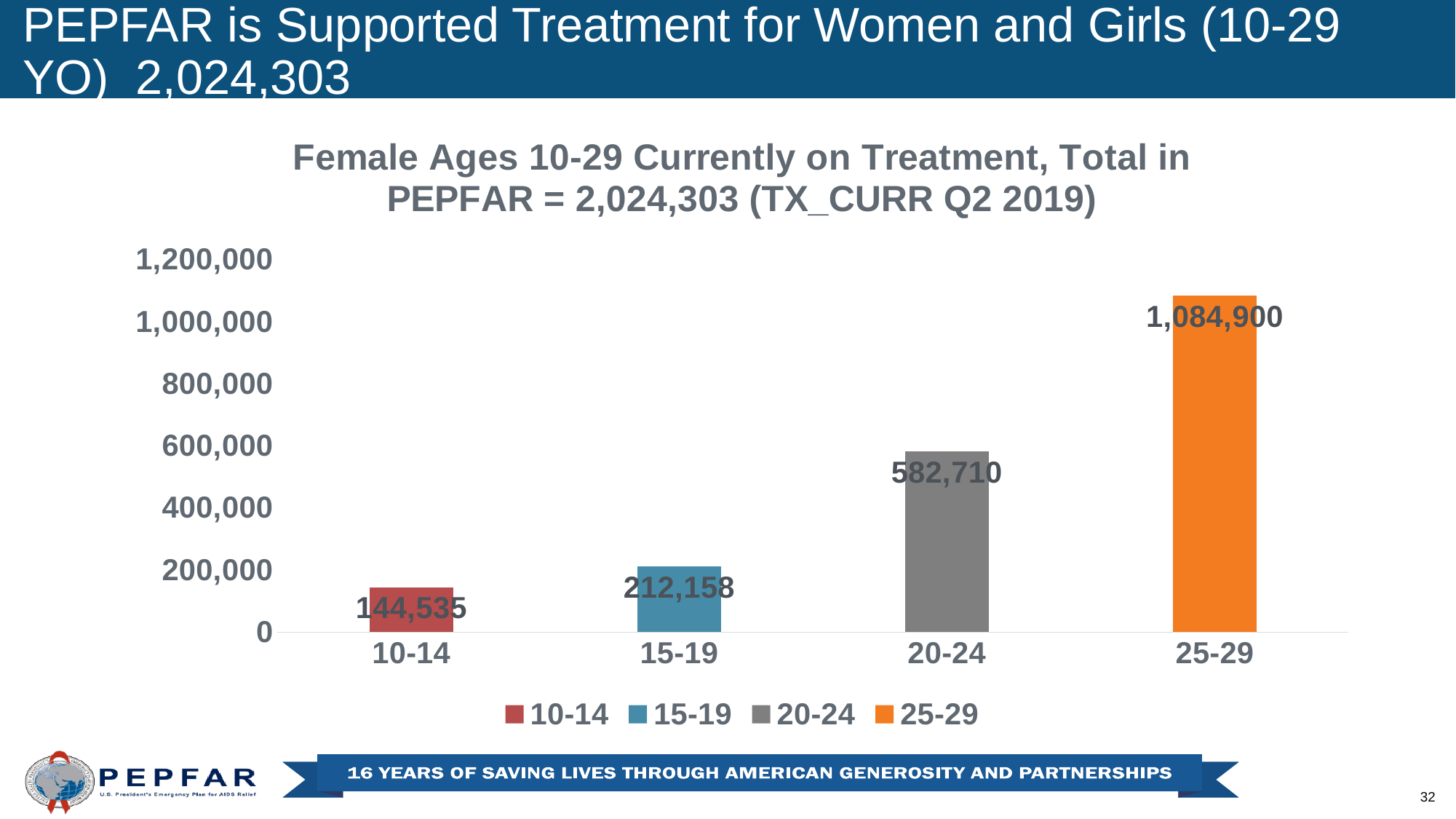
What is the value for the 20-24 age group? 582,710 What colour is the bar for the 25-29 age group? Orange How many age groups are plotted on the chart? 4 What type of chart is shown on the slide? Bar chart Which is larger, the value for 15-19 or the value for 20-24? 20-24 What is the value for the 15-19 age group? 212,158 What is the value for the 10-14 age group? 144,535 What is the difference between the values for the 25-29 and 20-24 age groups? 502,190 Which age group has the lowest value? 10-14 Do the values rise or fall as the age groups increase along the x axis? Rise Which age group has the highest value? 25-29 What is the value for the 25-29 age group? 1,084,900